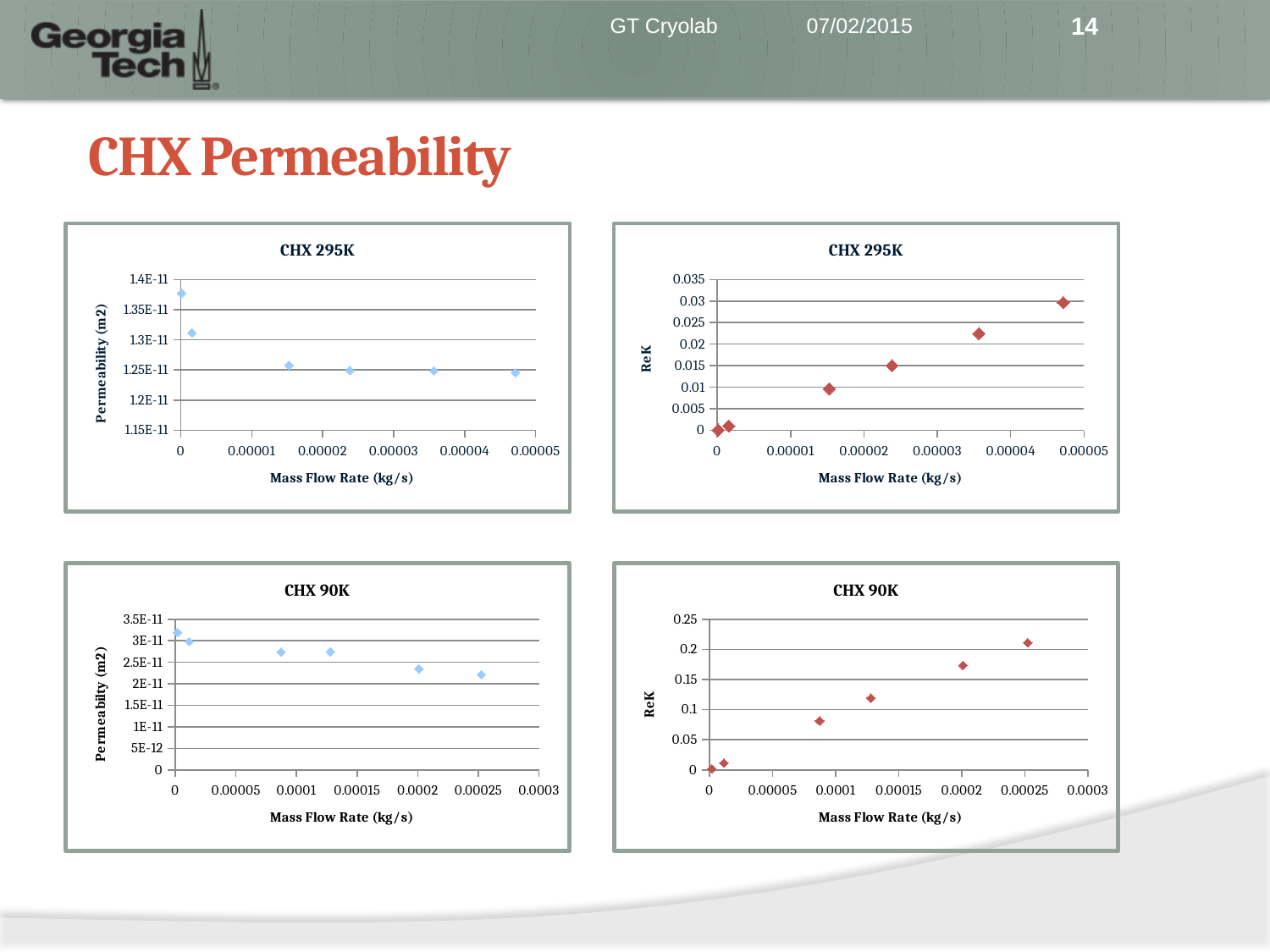
In the bottom-right CHX 90K ReK chart, which has the larger ReK: the point near mass flow rate 0.0001 or the point near 0.0002? the point near 0.0002 In the bottom-right CHX 90K ReK chart, is the ReK value of the point near mass flow rate 0.00025 greater or less than 0.2? greater How many data points are plotted in the top-right CHX 295K chart (ReK vs Mass Flow Rate)? 6 What kind of chart is the top-left chart titled CHX 295K (Permeability vs Mass Flow Rate)? scatter chart How many data points are plotted in the bottom-right CHX 90K chart (ReK vs Mass Flow Rate)? 6 What is the x-axis label of the bottom-left CHX 90K chart? Mass Flow Rate (kg/s) In the top-left CHX 295K permeability chart, is the permeability of the point at mass flow rate 0 greater or less than 1.35E-11? greater In the top-right CHX 295K ReK chart, does ReK rise or fall as mass flow rate increases? rise In the bottom-left CHX 90K permeability chart, does permeability rise or fall as mass flow rate increases? fall In the top-left CHX 295K permeability chart, does permeability rise or fall as mass flow rate increases? fall In the bottom-left CHX 90K permeability chart, is the permeability of the point near mass flow rate 0.00025 greater or less than 2.5E-11? less